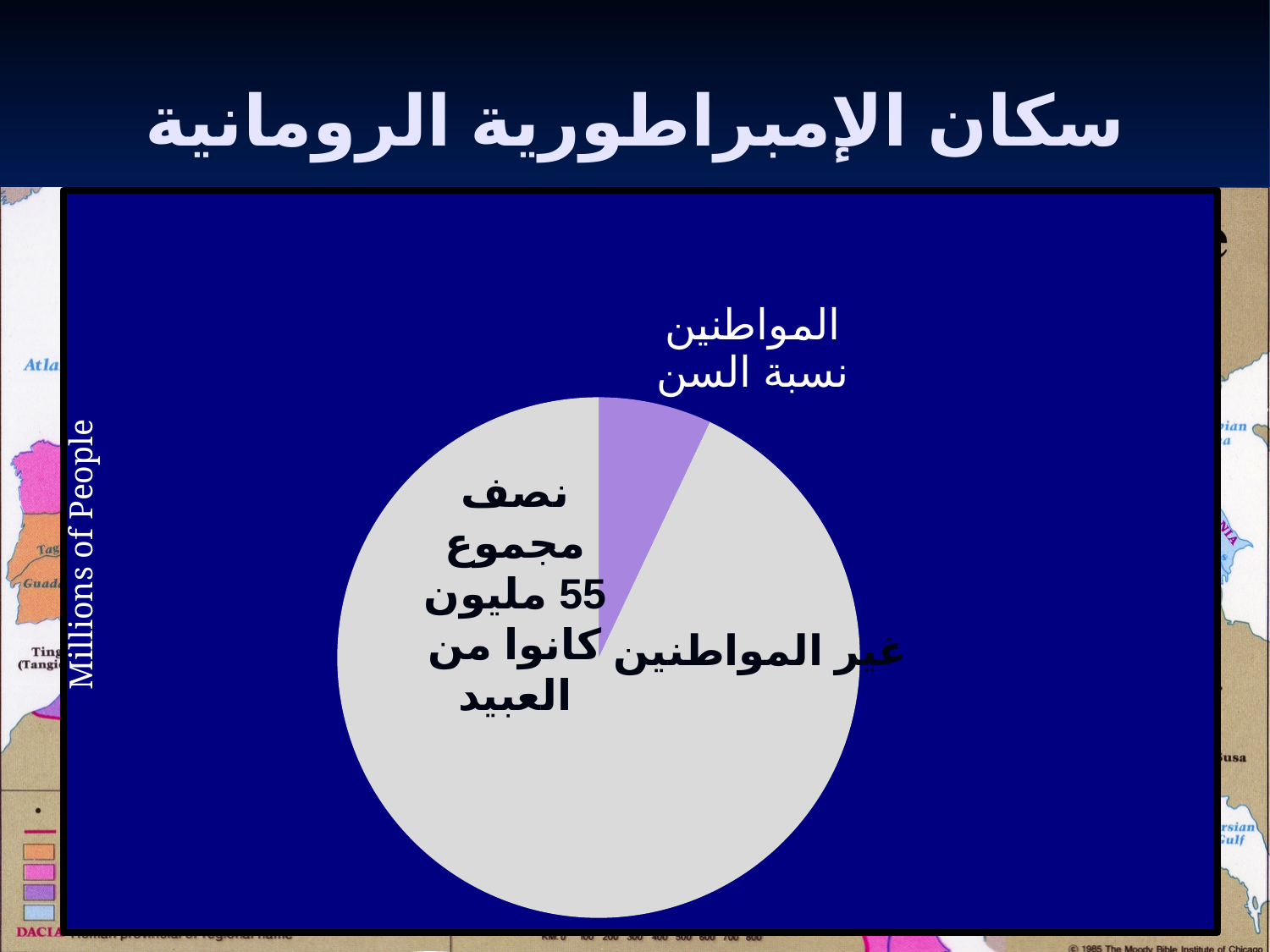
How many slices does the pie chart have? 2 What is the title of the slide containing the pie chart? سكان الإمبراطورية الرومانية Which slice of the pie chart is the smallest? المواطنين Which slice is larger, المواطنين or غير المواطنين? غير المواطنين What kind of chart is shown on the slide? pie chart What colour is the slice for غير المواطنين in the pie chart? grey Which slice of the pie chart is the largest? غير المواطنين